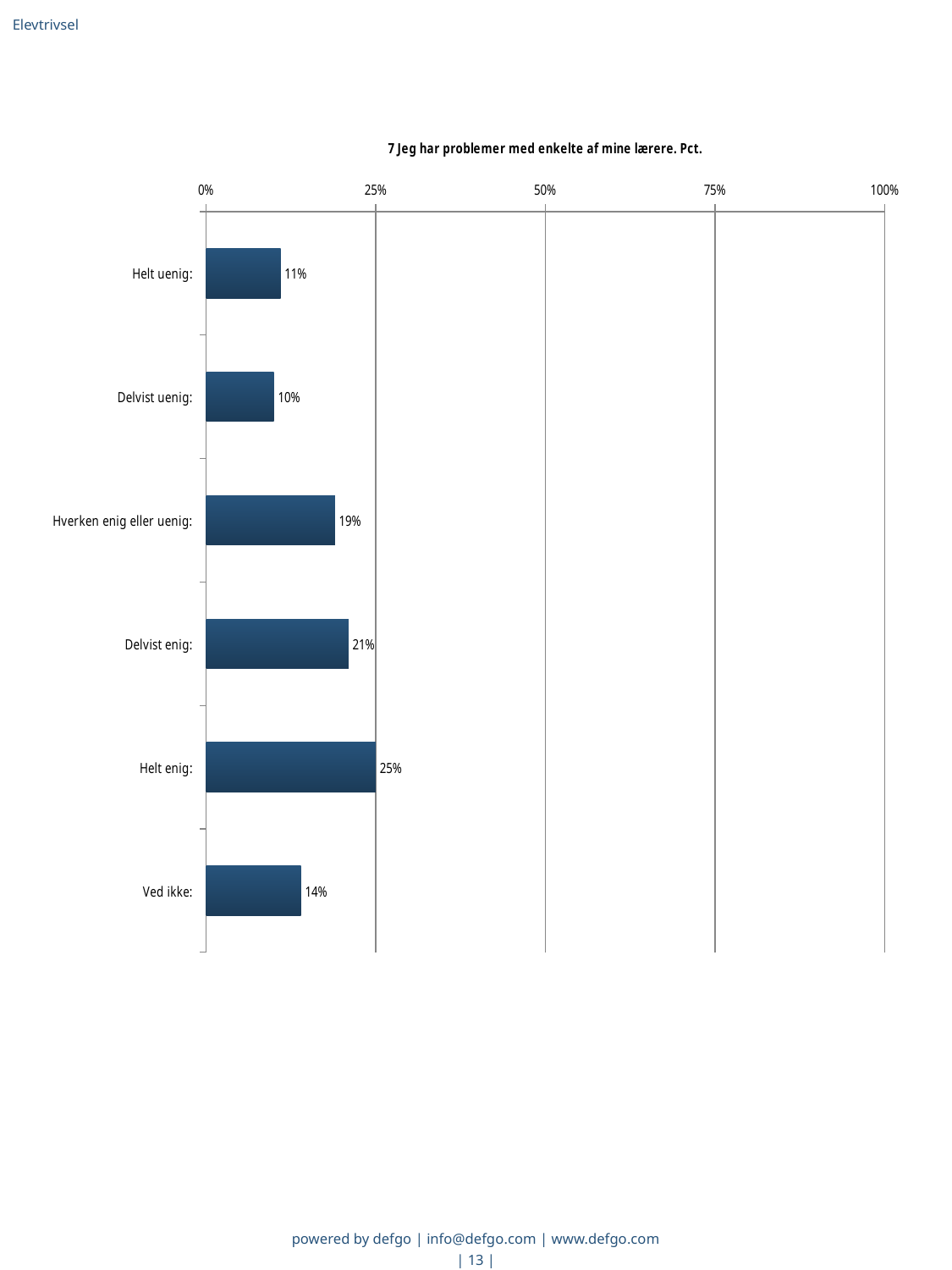
What is the title of the chart? 7 Jeg har problemer med enkelte af mine lærere. Pct. How many categories are shown in the chart? 6 What is the value for "Helt uenig"? 11% What is the value for "Hverken enig eller uenig"? 19% Is the value for "Delvist enig" greater or less than 25%? less Which category has the highest value? Helt enig Which is larger, the value for "Hverken enig eller uenig" or the value for "Ved ikke"? Hverken enig eller uenig What is the value for "Ved ikke"? 14% What is the difference between the values for "Helt enig" and "Delvist enig"? 4% Which category has the lowest value? Delvist uenig What kind of chart is shown on the slide? bar chart What is the highest value shown on the x axis? 100%